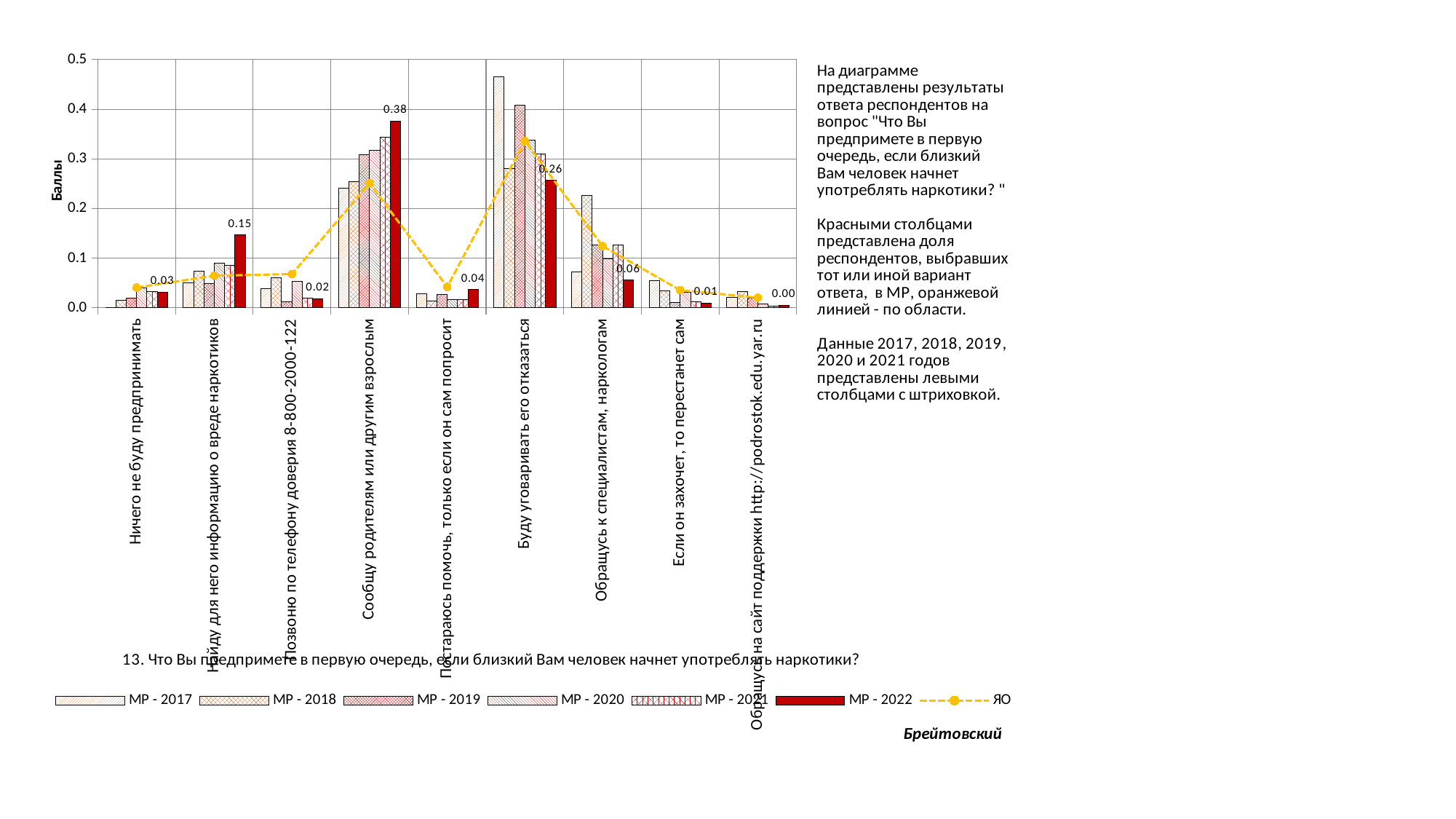
What is the MP - 2022 value for "Обращусь к специалистам, наркологам"? 0.06 Which category has the lowest MP - 2022 value? Обращусь на сайт поддержки http://podrostok.edu.yar.ru What is the difference between the MP - 2022 values for "Сообщу родителям или другим взрослым" and "Буду уговаривать его отказаться"? 0.12 What is the MP - 2022 value for "Найду для него информацию о вреде наркотиков"? 0.15 Which category has the highest MP - 2022 value? Сообщу родителям или другим взрослым How many series does the legend list? 7 Which is larger for MP - 2022: "Найду для него информацию о вреде наркотиков" or "Обращусь к специалистам, наркологам"? Найду для него информацию о вреде наркотиков How many categories are shown on the x axis? 9 What is the label of the y axis? Баллы Is the MP - 2017 value for "Буду уговаривать его отказаться" greater or less than 0.4? greater What is the MP - 2022 value for "Сообщу родителям или другим взрослым"? 0.38 What is the MP - 2022 value for "Буду уговаривать его отказаться"? 0.26